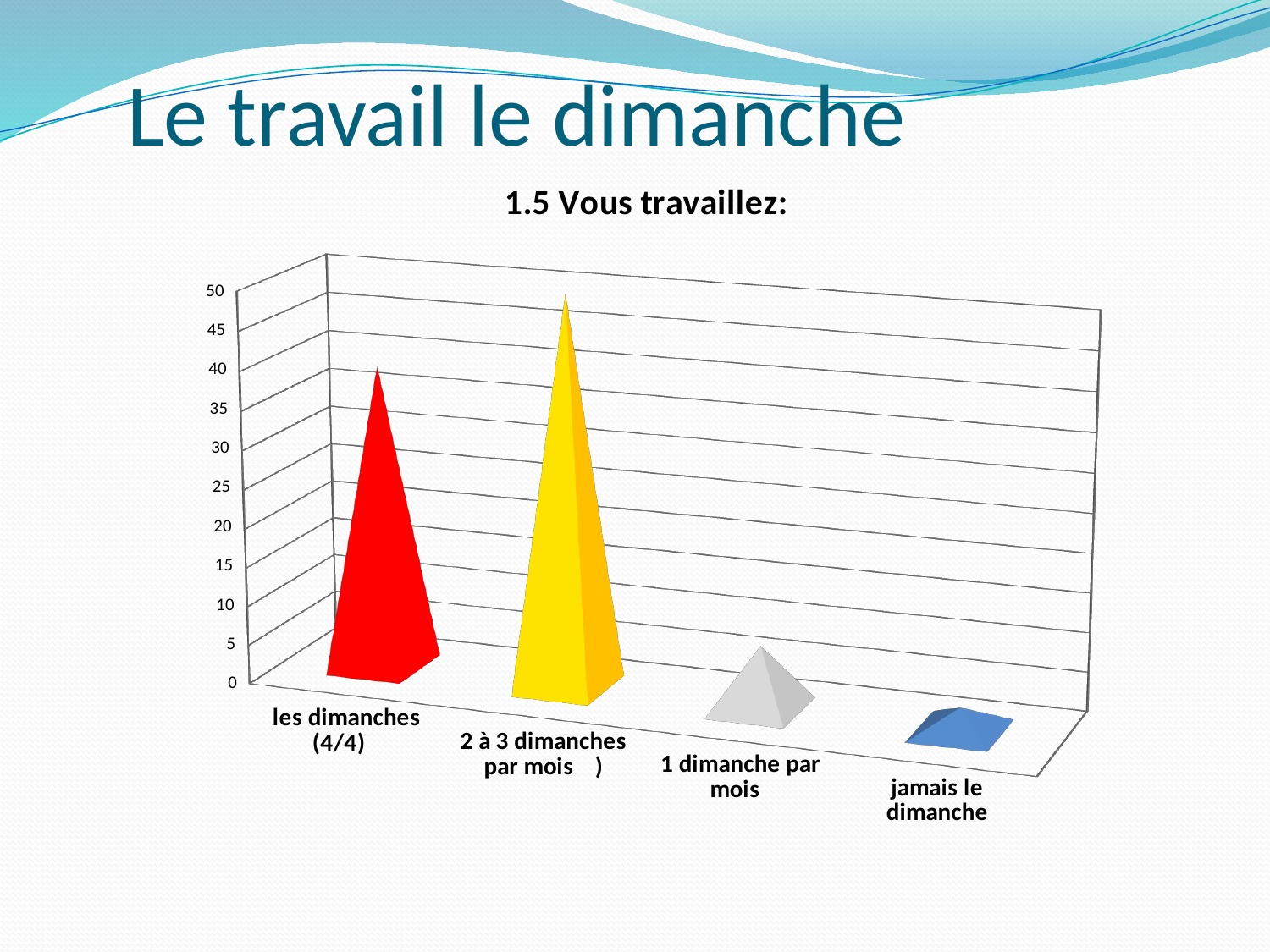
Is the value for 'jamais le dimanche' greater or less than 5? less Is the value for '2 à 3 dimanches par mois' greater or less than 40? greater What kind of chart is shown on the slide? bar chart What colour is the bar for 'les dimanches (4/4)'? red Which is larger: the value for 'les dimanches (4/4)' or the value for '2 à 3 dimanches par mois'? 2 à 3 dimanches par mois Which category has the lowest value in the chart? jamais le dimanche How many categories are shown on the x axis of the chart? 4 Is the value for '1 dimanche par mois' greater or less than 10? less Which category has the highest value in the chart? 2 à 3 dimanches par mois What is the title of the chart? 1.5 Vous travaillez: Which is larger: the value for '1 dimanche par mois' or the value for 'jamais le dimanche'? 1 dimanche par mois